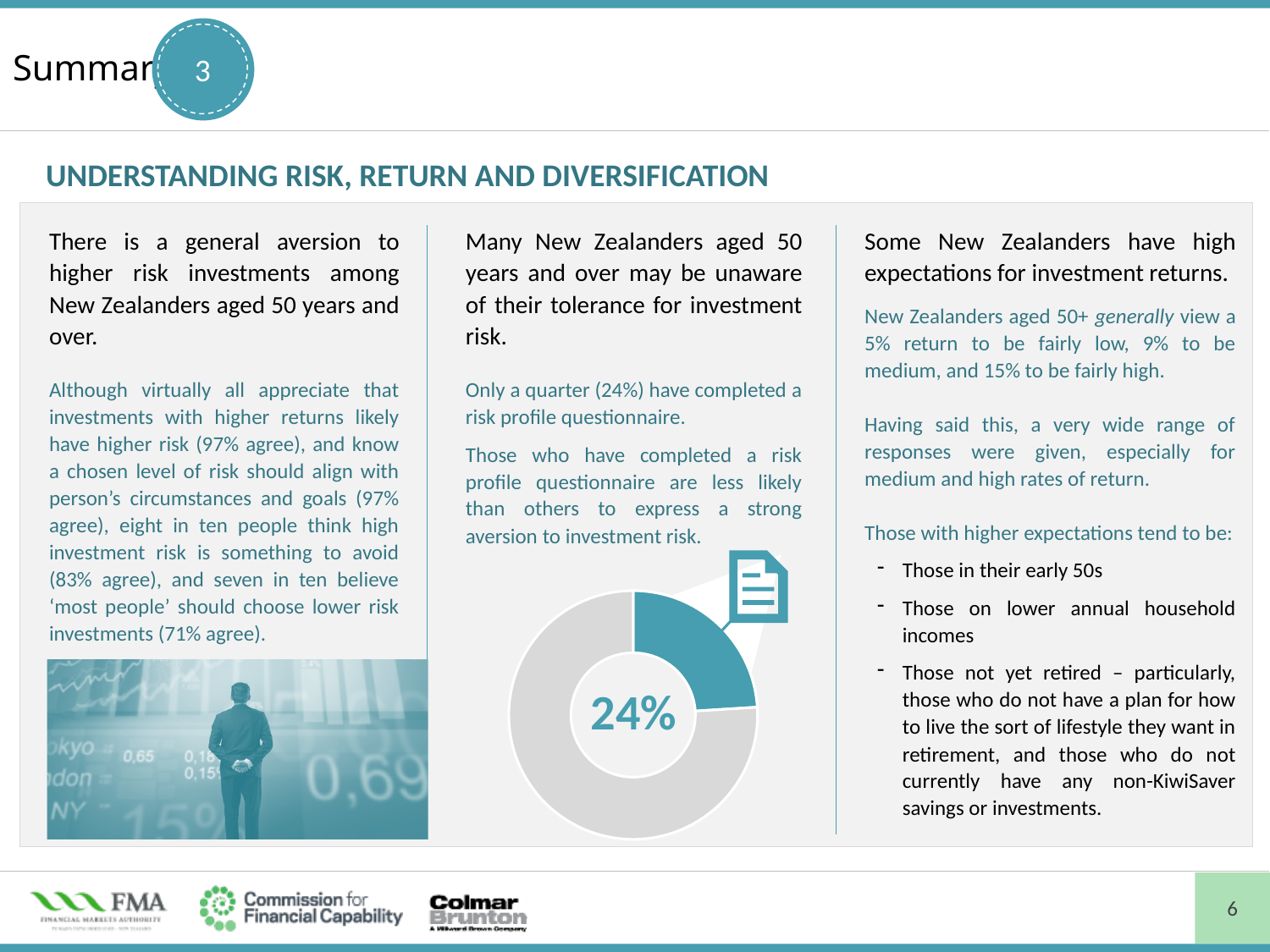
In the donut chart, which slice is larger: the teal slice or the grey slice? The grey slice Is the value shown for the highlighted slice of the donut chart greater or less than 50%? less How many slices does the donut chart have? 2 What percentage is printed in the centre of the donut chart? 24% What kind of chart is shown in the middle panel of the slide? Pie chart (donut) According to the donut chart, what share of New Zealanders aged 50 and over have completed a risk profile questionnaire? 24% What colour is the highlighted slice of the donut chart that represents 24%? Teal